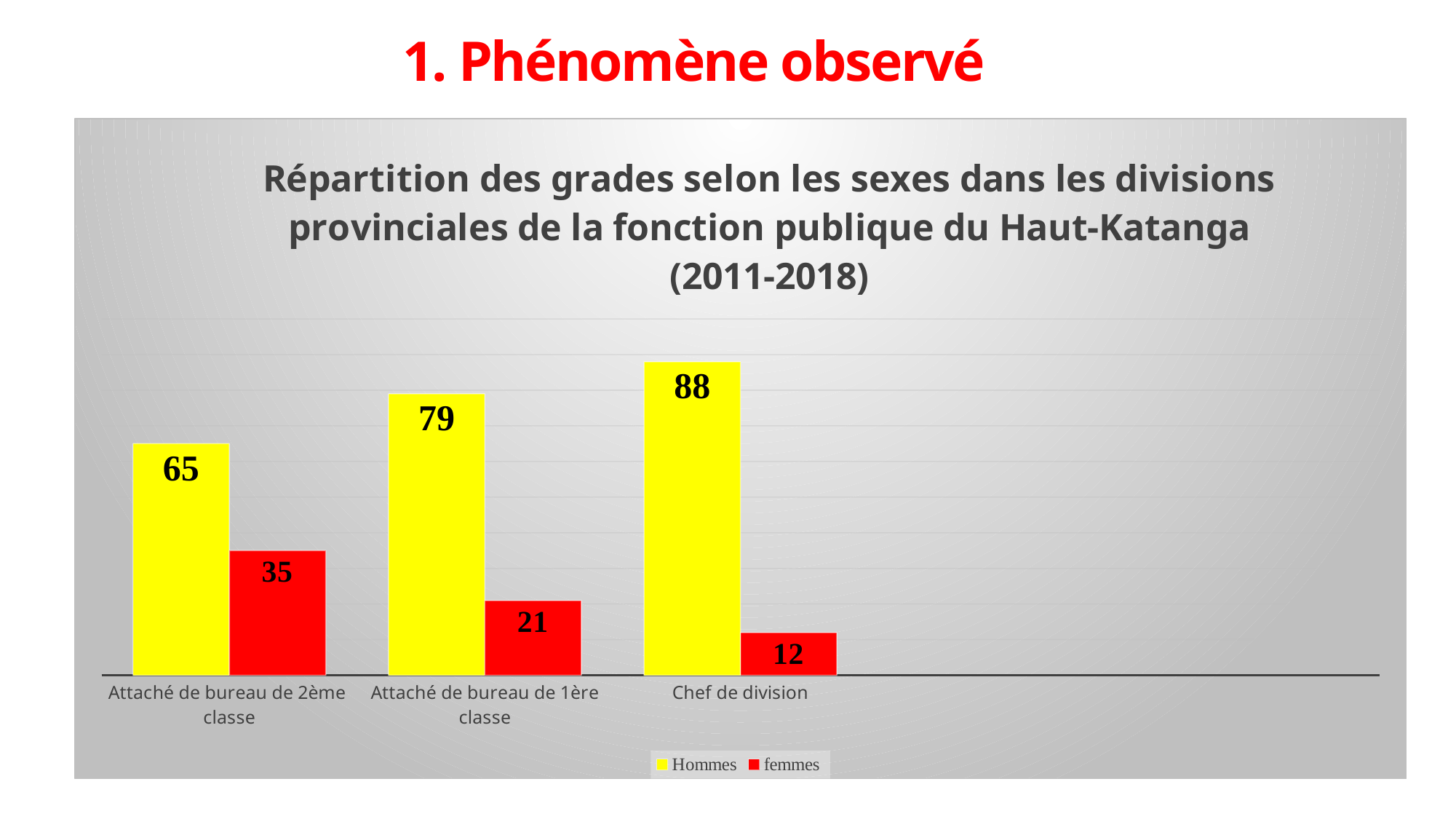
What is the value for femmes in the Attaché de bureau de 2ème classe category? 35 What is the value for Hommes in the Chef de division category? 88 Which category has the highest value for Hommes? Chef de division Do the femmes values rise or fall from left to right across the categories? Fall What kind of chart is shown on the slide? Bar chart What is the value for femmes in the Attaché de bureau de 1ère classe category? 21 What is the difference between the Hommes and femmes values for Chef de division? 76 Which is larger: the femmes value for Attaché de bureau de 2ème classe or the femmes value for Attaché de bureau de 1ère classe? Attaché de bureau de 2ème classe What is the difference between the Hommes values for Attaché de bureau de 1ère classe and Attaché de bureau de 2ème classe? 14 How many series does the legend list? 2 Which category has the lowest value for femmes? Chef de division How many categories are shown on the x axis? 3